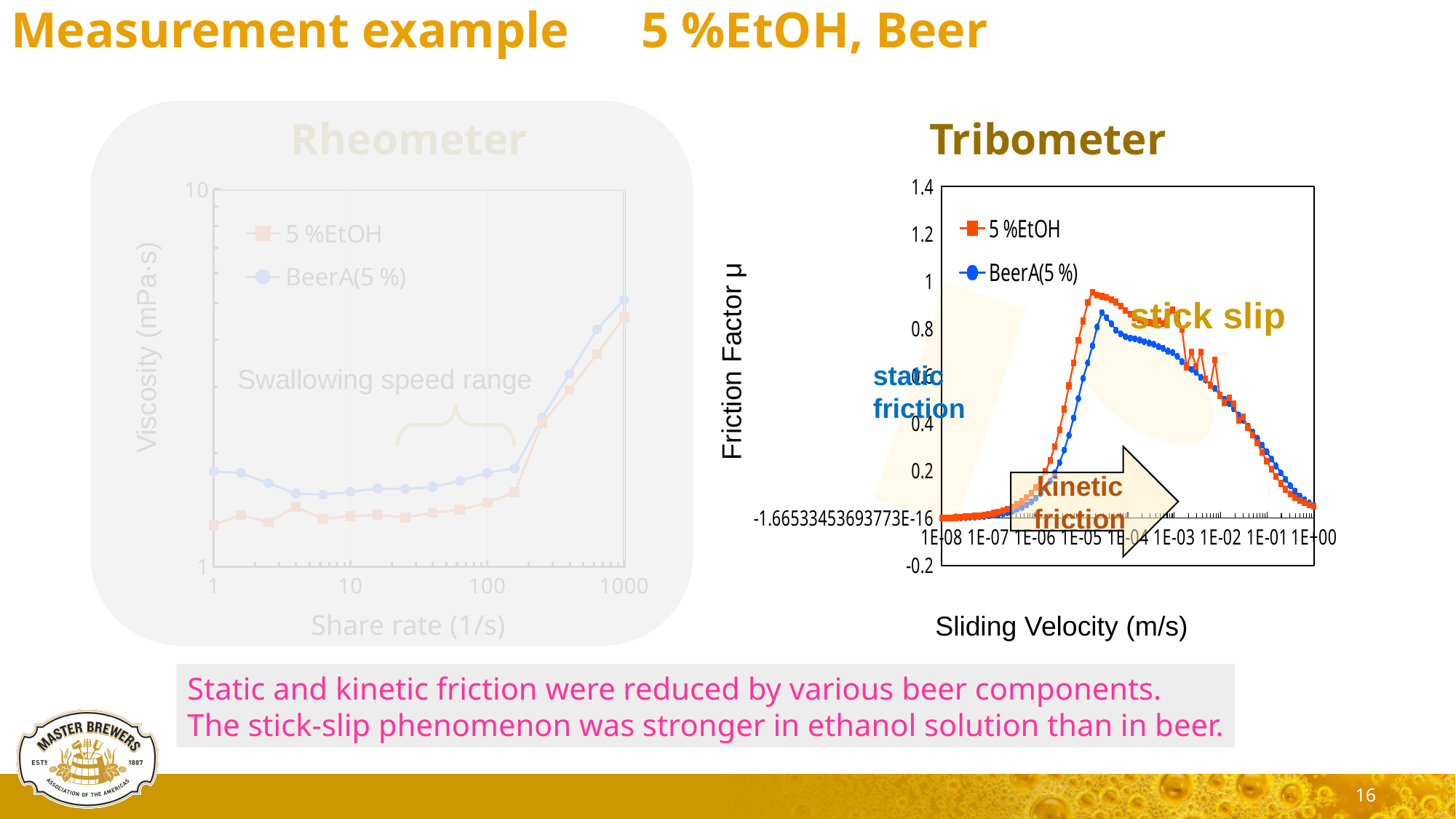
In the Tribometer chart, what is the label of the y axis? Friction Factor μ In the Tribometer chart, which series reaches the higher peak friction factor? 5 %EtOH In the Tribometer chart, what is the highest tick value shown on the y axis? 1.4 In the Tribometer chart, do the friction factor values rise or fall as sliding velocity increases from 1E-03 to 1E+00? fall How many series does the legend of the Rheometer chart list? 2 In the Rheometer chart, do the viscosity values rise or fall as the share rate increases from 100 to 1000? rise In the Rheometer chart, which series shows the higher viscosity at a share rate of 1? BeerA(5 %) What type of chart is the Tribometer chart? line chart In the Tribometer chart, is the peak value of the 5 %EtOH series greater or less than 0.8? greater In the Tribometer chart, what is the label of the x axis? Sliding Velocity (m/s) In the Tribometer chart, is the peak value of the BeerA(5 %) series greater or less than 1? less How many series does the legend of the Tribometer chart list? 2